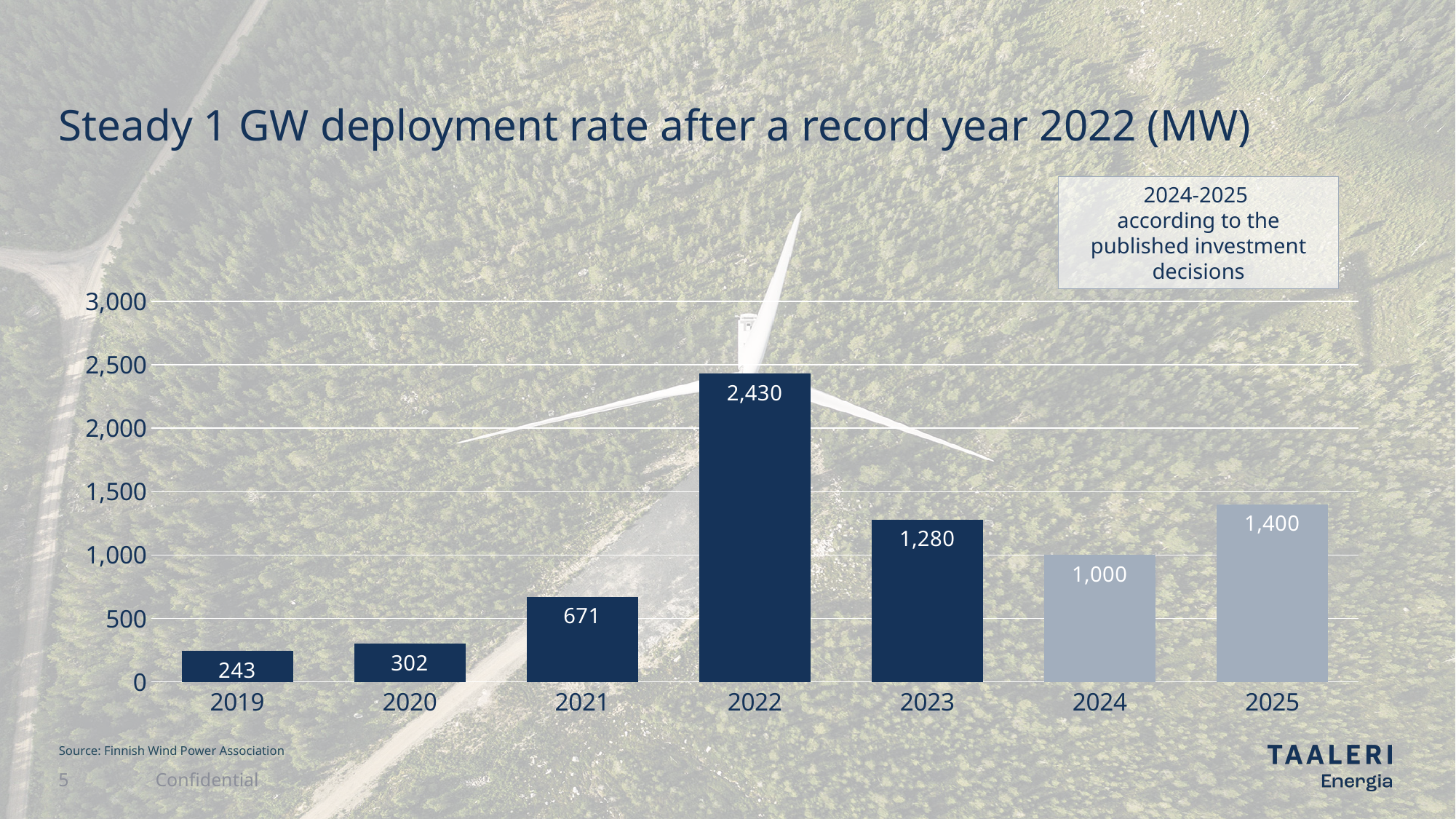
Which year has the highest value? 2022 Do the values rise or fall from 2019 to 2022? rise What is the value for 2024? 1,000 What kind of chart is shown on the slide? bar chart Which is larger, the value for 2025 or the value for 2023? 2025 What is the value for 2019? 243 What is the difference between the values for 2021 and 2020? 369 Is the value for 2021 greater or less than 500? greater Which year has the lowest value? 2019 What is the difference between the values for 2022 and 2023? 1,150 What is the value for 2022? 2,430 How many years are shown on the x axis? 7